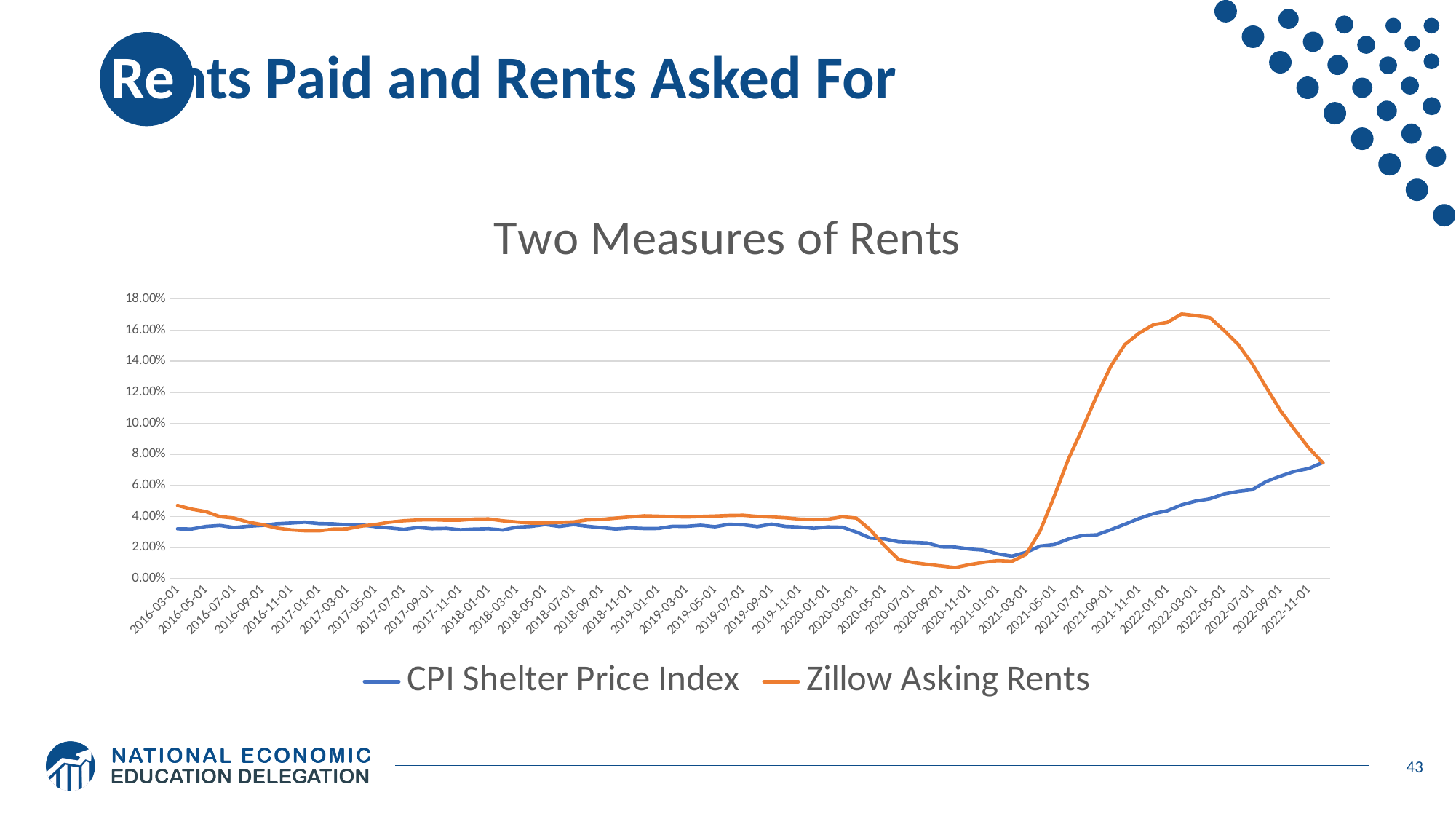
Does the CPI Shelter Price Index rise or fall between 2021-03-01 and 2022-11-01? rise At 2020-11-01, which series has the higher value, CPI Shelter Price Index or Zillow Asking Rents? CPI Shelter Price Index What kind of chart is shown on the slide? line chart What is the title of the chart? Two Measures of Rents Which series is drawn in orange? Zillow Asking Rents Is the value for Zillow Asking Rents at 2022-03-01 greater or less than 16.00%? greater At 2022-03-01, which series has the higher value, CPI Shelter Price Index or Zillow Asking Rents? Zillow Asking Rents How many series does the legend list? 2 Which series reaches the highest value anywhere on the chart? Zillow Asking Rents Is the value for CPI Shelter Price Index at 2022-11-01 greater or less than 6.00%? greater Is the value for CPI Shelter Price Index at 2016-03-01 greater or less than 4.00%? less